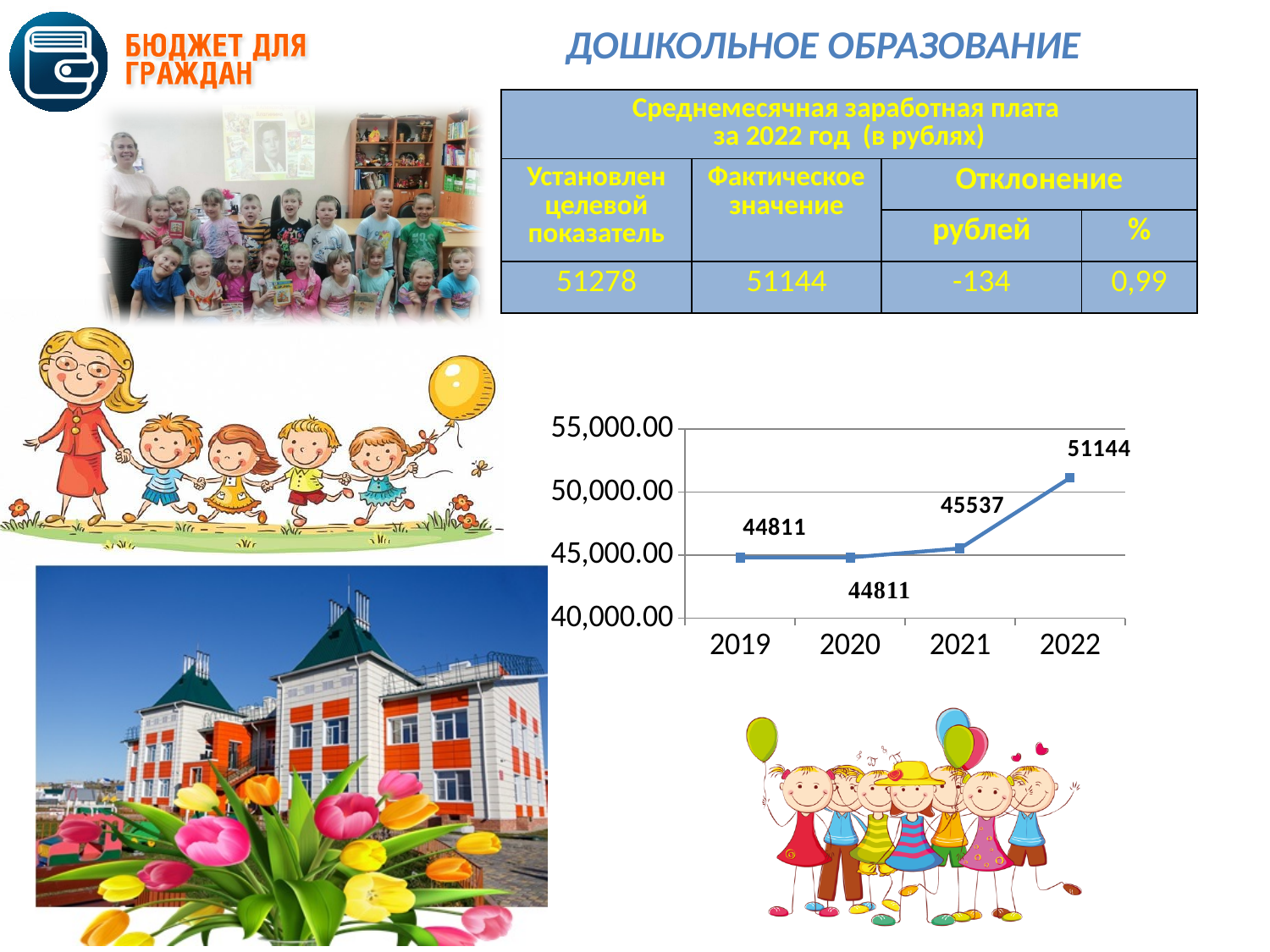
What is the difference between the values for 2021 and 2020 in the line chart? 726 What is the value for 2019 in the line chart? 44811 What is the value for 2021 in the line chart? 45537 Which year has the highest value in the line chart? 2022 What is the value for 2020 in the line chart? 44811 What is the value for 2022 in the line chart? 51144 Which is larger in the line chart, the value for 2021 or the value for 2022? 2022 Do the values in the line chart rise or fall from 2019 to 2022? rise Is the value for 2022 in the line chart greater or less than 50,000.00? greater What is the difference between the values for 2022 and 2021 in the line chart? 5607 What type of chart is shown on the slide? line chart How many years are plotted on the x axis of the line chart? 4